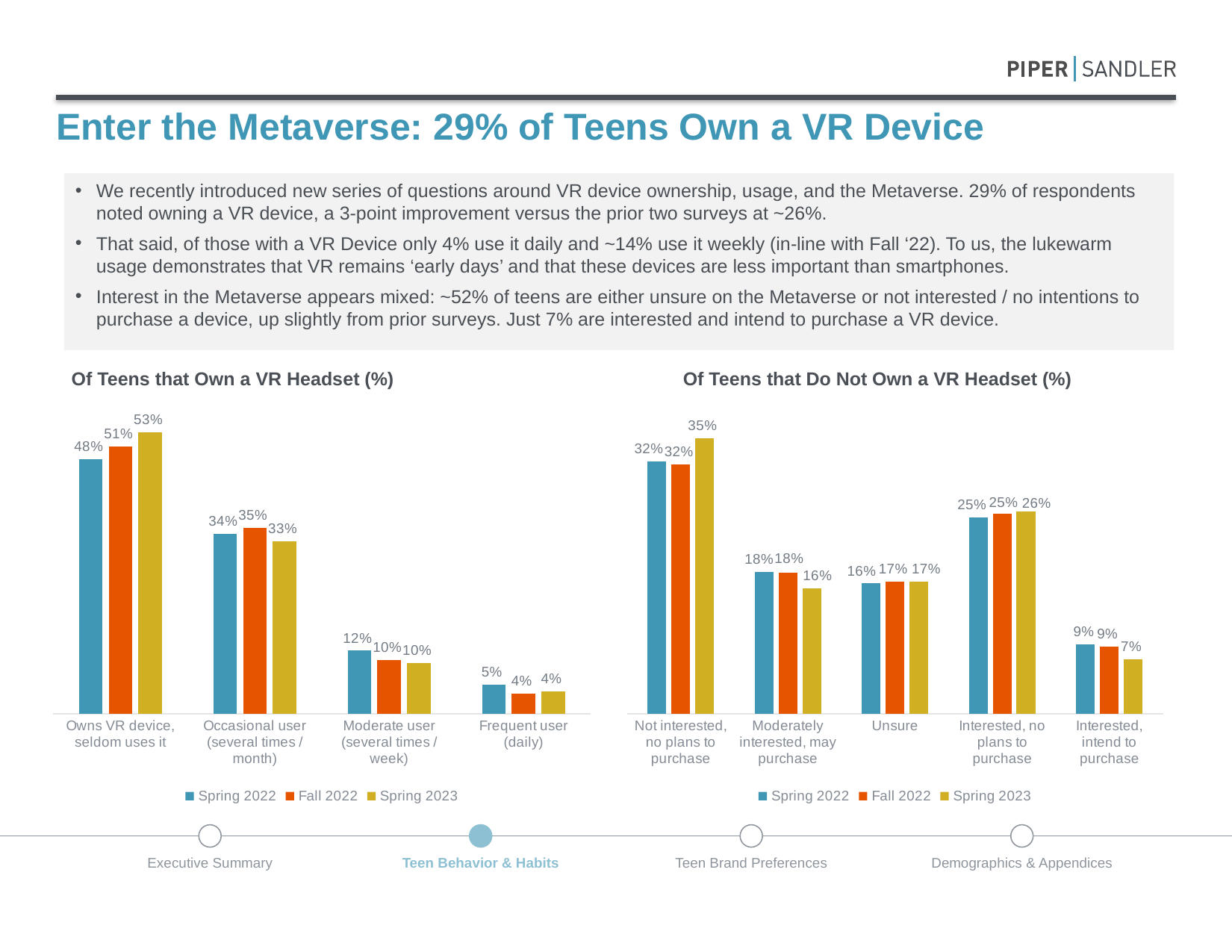
In the 'Of Teens that Own a VR Headset (%)' chart, what is the Fall 2022 value for 'Moderate user (several times / week)'? 10% In the 'Of Teens that Own a VR Headset (%)' chart, how many categories are shown on the x axis? 4 What kind of chart is the 'Of Teens that Do Not Own a VR Headset (%)' chart? Bar chart In the 'Of Teens that Own a VR Headset (%)' chart, which category has the highest Spring 2022 value? Owns VR device, seldom uses it In the 'Of Teens that Do Not Own a VR Headset (%)' chart, what is the Spring 2023 value for 'Not interested, no plans to purchase'? 35% In the 'Of Teens that Do Not Own a VR Headset (%)' chart, which is larger: the Spring 2023 value for 'Moderately interested, may purchase' or the Spring 2023 value for 'Interested, no plans to purchase'? Interested, no plans to purchase In the 'Of Teens that Own a VR Headset (%)' chart, what is the difference between the Spring 2023 and Spring 2022 values for 'Owns VR device, seldom uses it'? 5% In the 'Of Teens that Do Not Own a VR Headset (%)' chart, which category has the lowest Fall 2022 value? Interested, intend to purchase In the 'Of Teens that Do Not Own a VR Headset (%)' chart, how many series does the legend list? 3 In the 'Of Teens that Own a VR Headset (%)' chart, which category has the lowest Spring 2023 value? Frequent user (daily) In the 'Of Teens that Do Not Own a VR Headset (%)' chart, what is the Spring 2023 value for 'Interested, intend to purchase'? 7% In the 'Of Teens that Own a VR Headset (%)' chart, what is the Spring 2023 value for 'Owns VR device, seldom uses it'? 53%